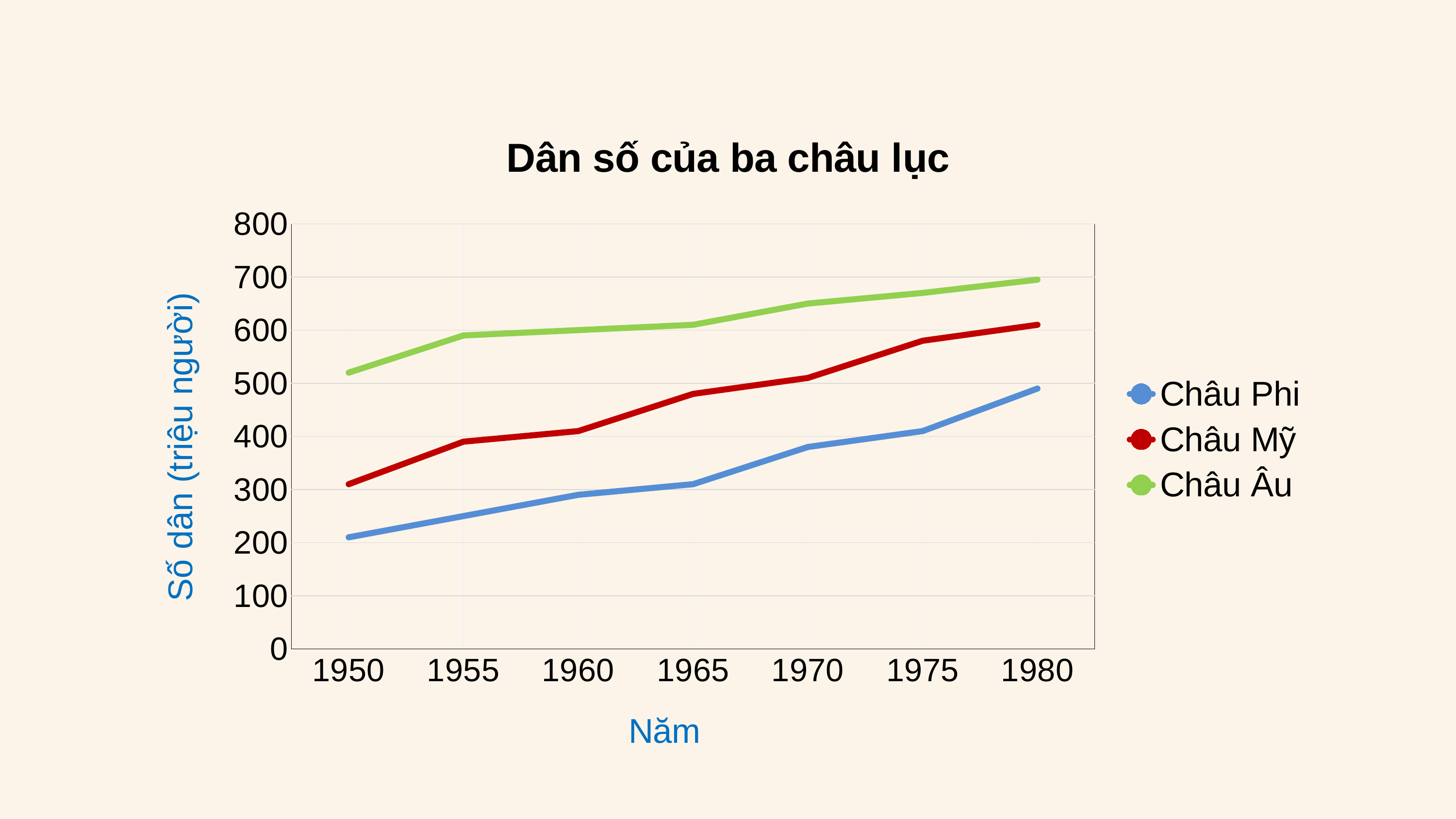
What is the title of the chart? Dân số của ba châu lục What kind of chart is shown on the slide? line chart What is the label of the vertical axis? Số dân (triệu người) Is the value for Châu Phi in 1950 greater or less than 300? less Which series has the highest value in 1980? Châu Âu How many years are shown on the x axis? 7 Do the values for Châu Mỹ rise or fall from 1950 to 1980? rise Is the value for Châu Âu in 1980 greater or less than 600? greater Which series has the lowest value in 1950? Châu Phi Which is larger in 1970, Châu Mỹ or Châu Phi? Châu Mỹ How many series does the legend list? 3 In which year does Châu Phi reach its highest value? 1980